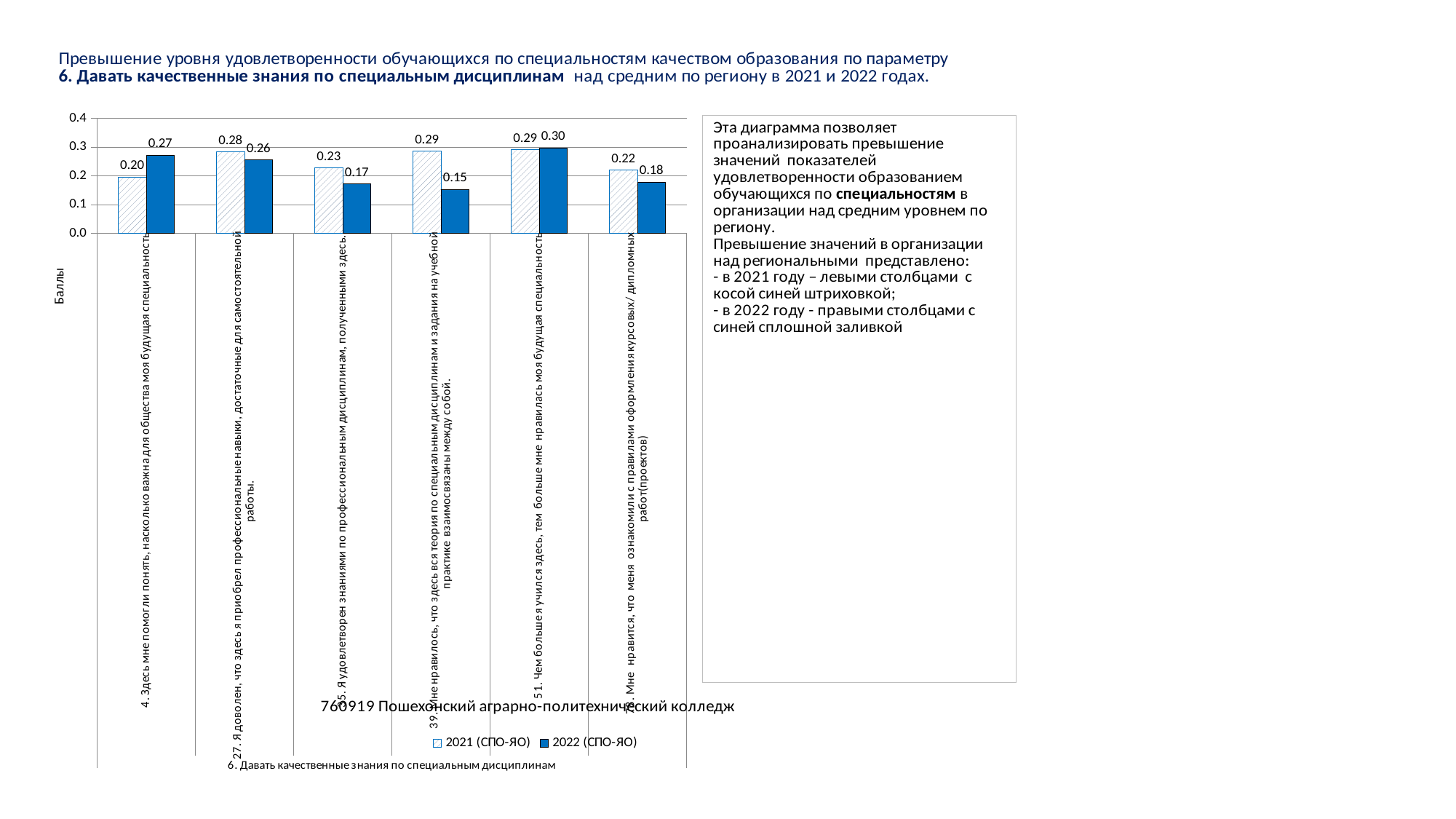
How many series does the chart legend list? 2 What is the value of the 2022 (СПО-ЯО) series for category "27. Я доволен, что здесь я приобрел профессиональные навыки, достаточные для самостоятельной работы"? 0.26 What is the title of the vertical axis of the chart? Баллы What is the value of the 2021 (СПО-ЯО) series for category "4. Здесь мне помогли понять, насколько важна для общества моя будущая специальность"? 0.20 What is the value of the 2022 (СПО-ЯО) series for category "39. Мне нравилось, что здесь вся теория по специальным дисциплинам и задания на учебной практике взаимосвязаны между собой"? 0.15 What kind of chart is shown on the slide? Bar chart Which category has the lowest value in the 2022 (СПО-ЯО) series? 39. Мне нравилось, что здесь вся теория по специальным дисциплинам и задания на учебной практике взаимосвязаны между собой What is the difference between the 2021 (СПО-ЯО) and 2022 (СПО-ЯО) values for category "39. Мне нравилось, что здесь вся теория по специальным дисциплинам и задания на учебной практике взаимосвязаны между собой"? 0.14 For category "35. Я удовлетворен знаниями по профессиональным дисциплинам, полученными здесь", which series has the larger value, 2021 (СПО-ЯО) or 2022 (СПО-ЯО)? 2021 (СПО-ЯО) Which category has the highest value in the 2022 (СПО-ЯО) series? 51. Чем больше я учился здесь, тем больше мне нравилась моя будущая специальность Which category has the lowest value in the 2021 (СПО-ЯО) series? 4. Здесь мне помогли понять, насколько важна для общества моя будущая специальность How many categories are shown on the x axis of the chart? 6